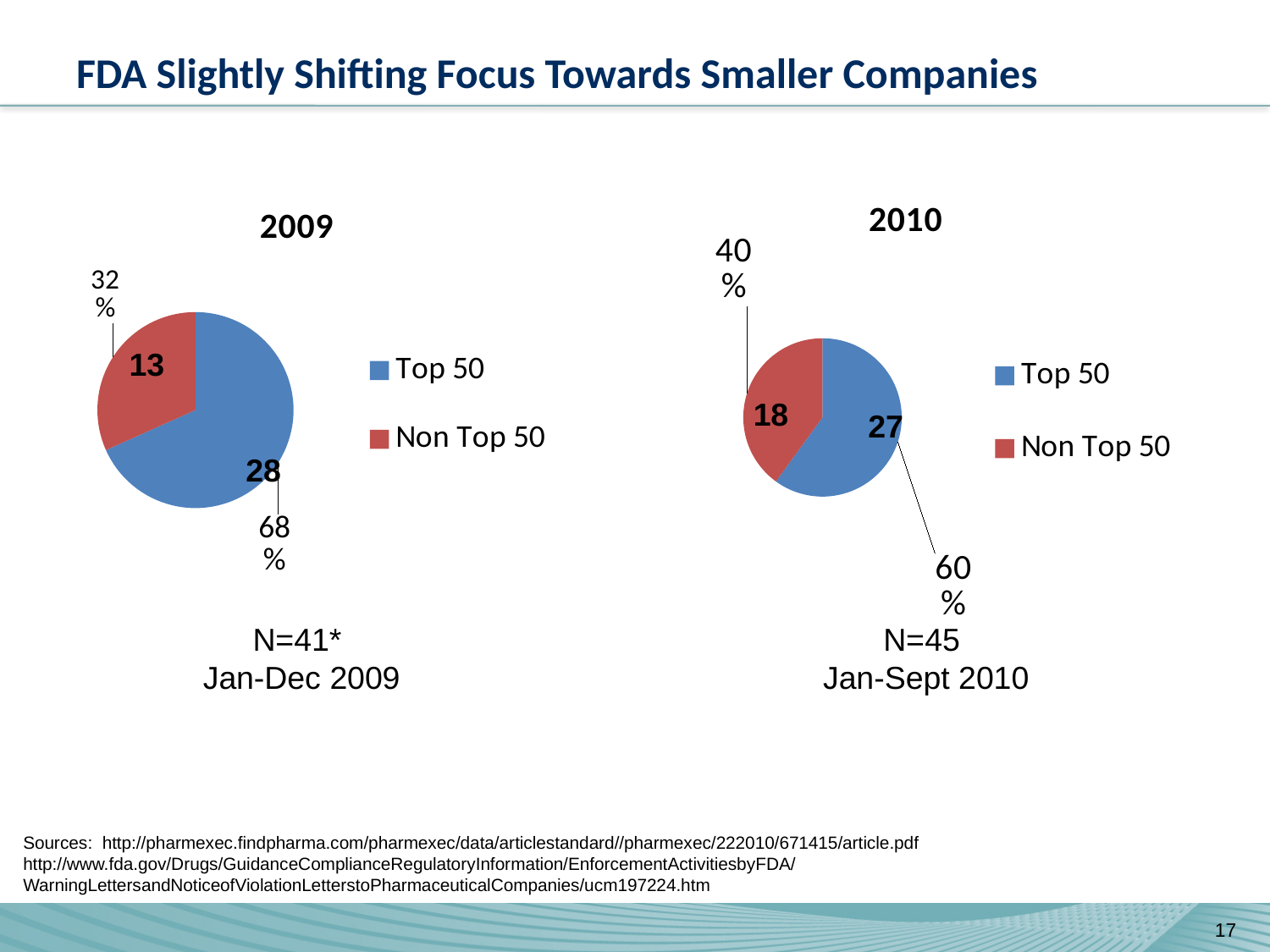
In the 2010 pie chart, what is the value for Non Top 50? 18 In the 2009 pie chart, what is the difference between the Top 50 and Non Top 50 values? 15 What kind of chart is the 2010 chart? Pie chart In the 2009 pie chart, what share of the pie does Non Top 50 represent? 32% In the 2009 pie chart, what is the value for Non Top 50? 13 In the 2010 pie chart, which category is the smallest? Non Top 50 In the 2010 pie chart, what is the difference between the Top 50 and Non Top 50 values? 9 In the 2010 pie chart, what is the value for Top 50? 27 In the 2009 pie chart, what is the value for Top 50? 28 How many entries does the legend of the 2009 chart list? 2 In the 2010 pie chart, what share of the pie does Top 50 represent? 60% In the 2009 pie chart, which category is the largest? Top 50